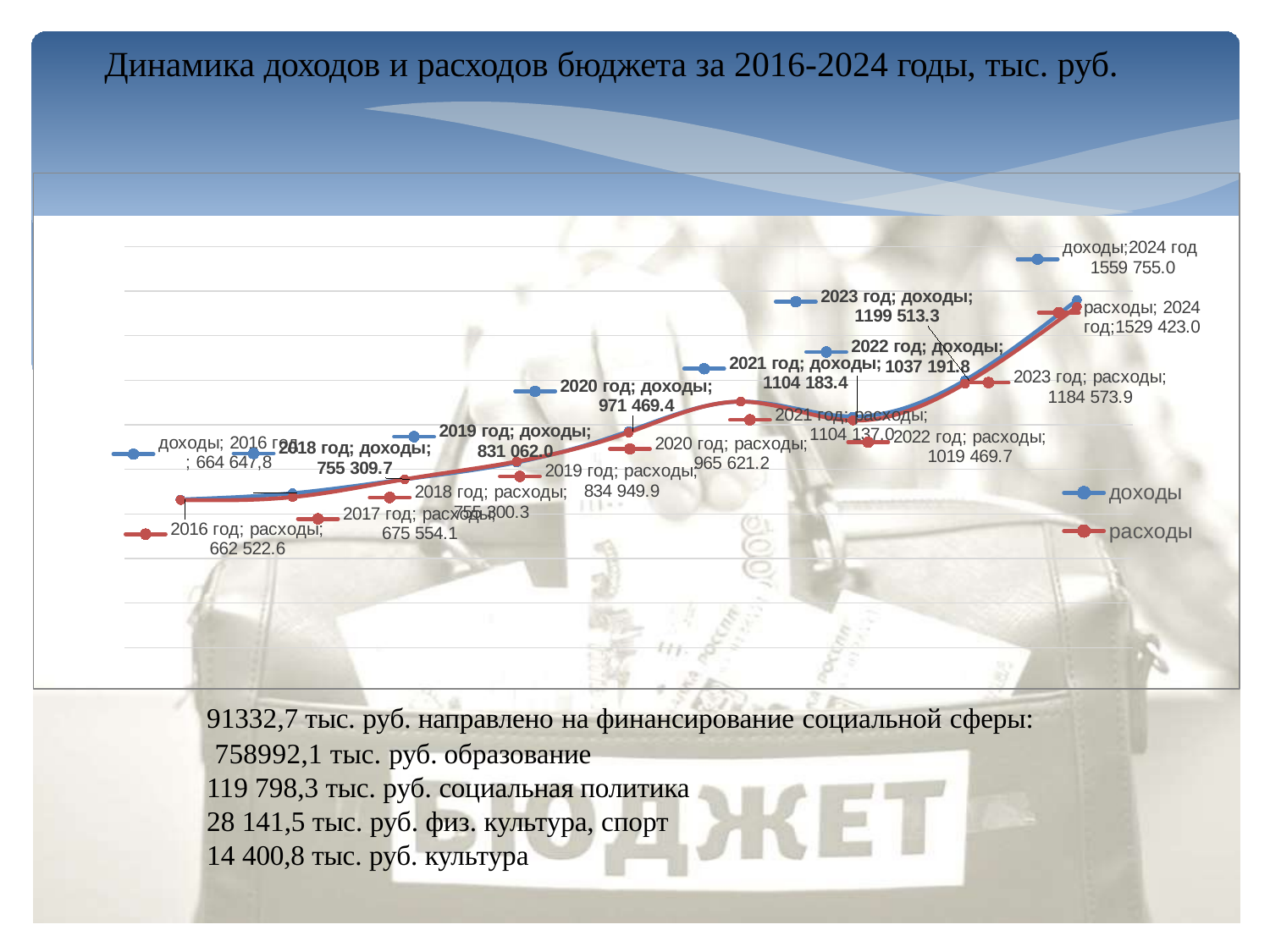
In which year is доходы highest? 2024 год What kind of chart is shown on the slide? line chart What is the difference between доходы and расходы in 2024 год? 30 332.0 What is the difference between доходы and расходы in 2023 год? 14 939.4 What is the value of доходы for 2021 год? 1104 183.4 Do the расходы values generally rise or fall from 2016 to 2024? rise Which is larger in 2022 год, доходы or расходы? доходы What is the value of расходы for 2022 год? 1019 469.7 In which year is расходы lowest? 2016 год What is the value of расходы for 2016 год? 662 522.6 What is the value of доходы for 2024 год? 1559 755.0 How many series does the legend list? 2